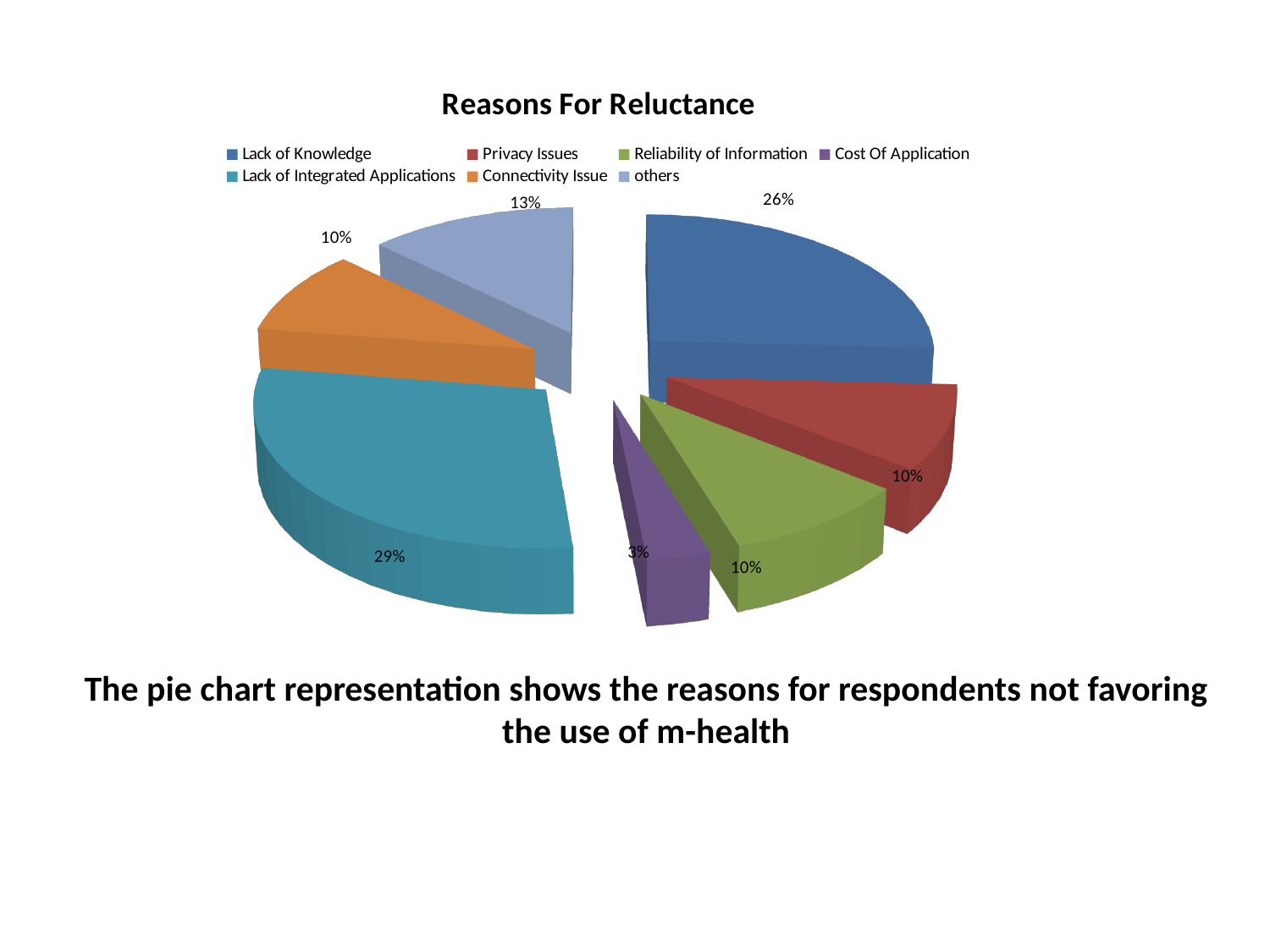
What is the difference in percentage points between Lack of Integrated Applications and Lack of Knowledge? 3 What type of chart is shown on the slide? Pie chart What percentage is shown for Cost Of Application? 3% What share of the pie does Lack of Integrated Applications represent? 29% What is the title of the chart? Reasons For Reluctance What percentage is shown for Lack of Knowledge? 26% Which is larger, the share for 'others' or the share for Privacy Issues? others What percentage is shown for the 'others' category? 13% Which reason has the largest share of the pie? Lack of Integrated Applications Which reason has the smallest share of the pie? Cost Of Application How many categories are shown in the pie chart? 7 What percentage is shown for Connectivity Issue? 10%